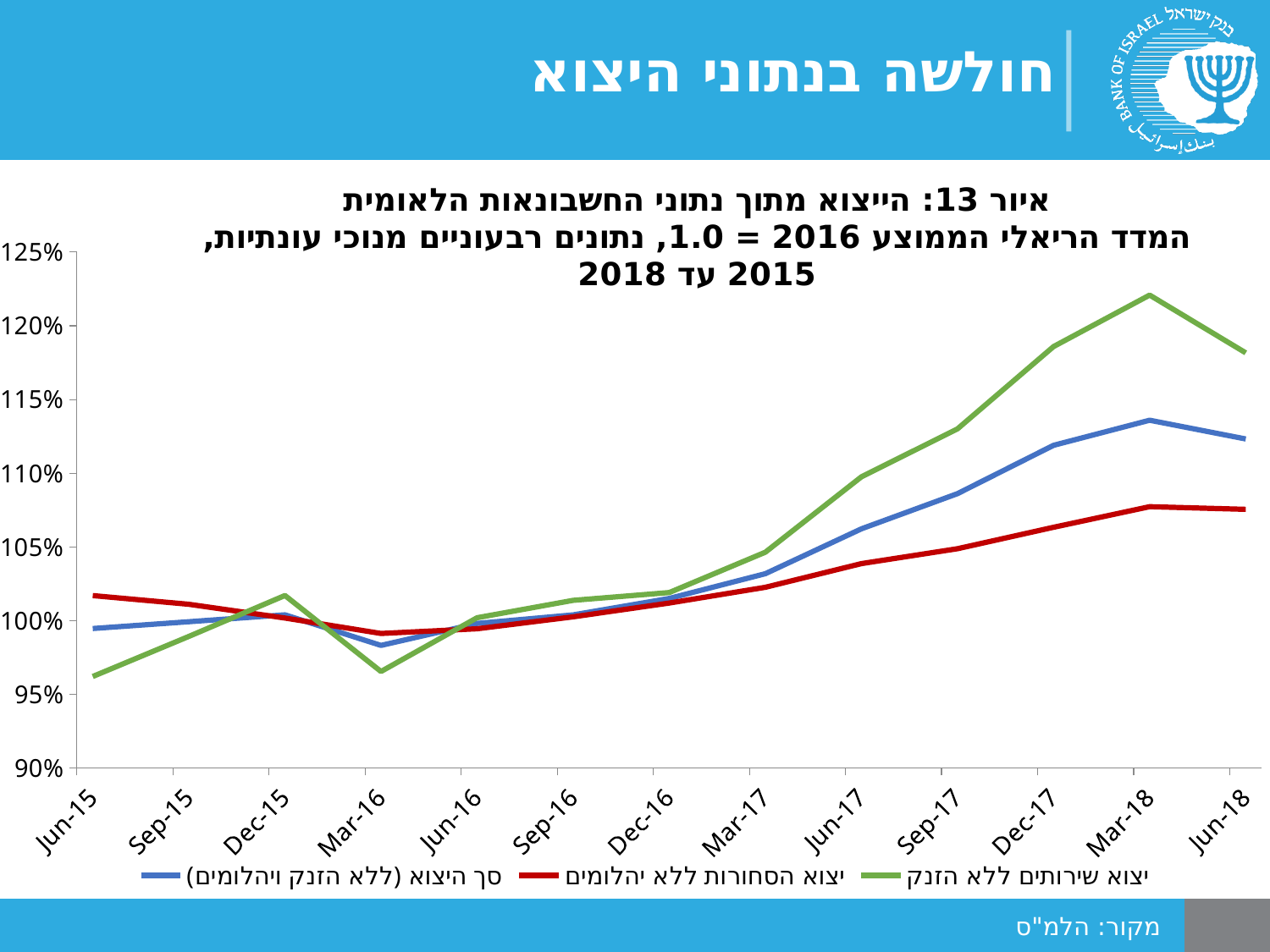
Is the value of the red line (יצוא הסחורות ללא יהלומים) at Jun-18 greater or less than 105%? greater At Jun-18, which is larger: the green line or the red line? the green line Is the value of the green line (יצוא שירותים ללא הזנק) at Mar-18 greater or less than 120%? greater Is the value of the green line at Jun-15 greater or less than 100%? less How many series does the legend list? 3 Which series has the lowest value at Jun-15? יצוא שירותים ללא הזנק What kind of chart is shown on the slide? line chart How many dates are labelled along the x axis? 13 Which series has the highest value at Mar-18? יצוא שירותים ללא הזנק What colour is the line for סך היצוא (ללא הזנק ויהלומים)? blue Does the green line rise or fall between Mar-17 and Mar-18? rise